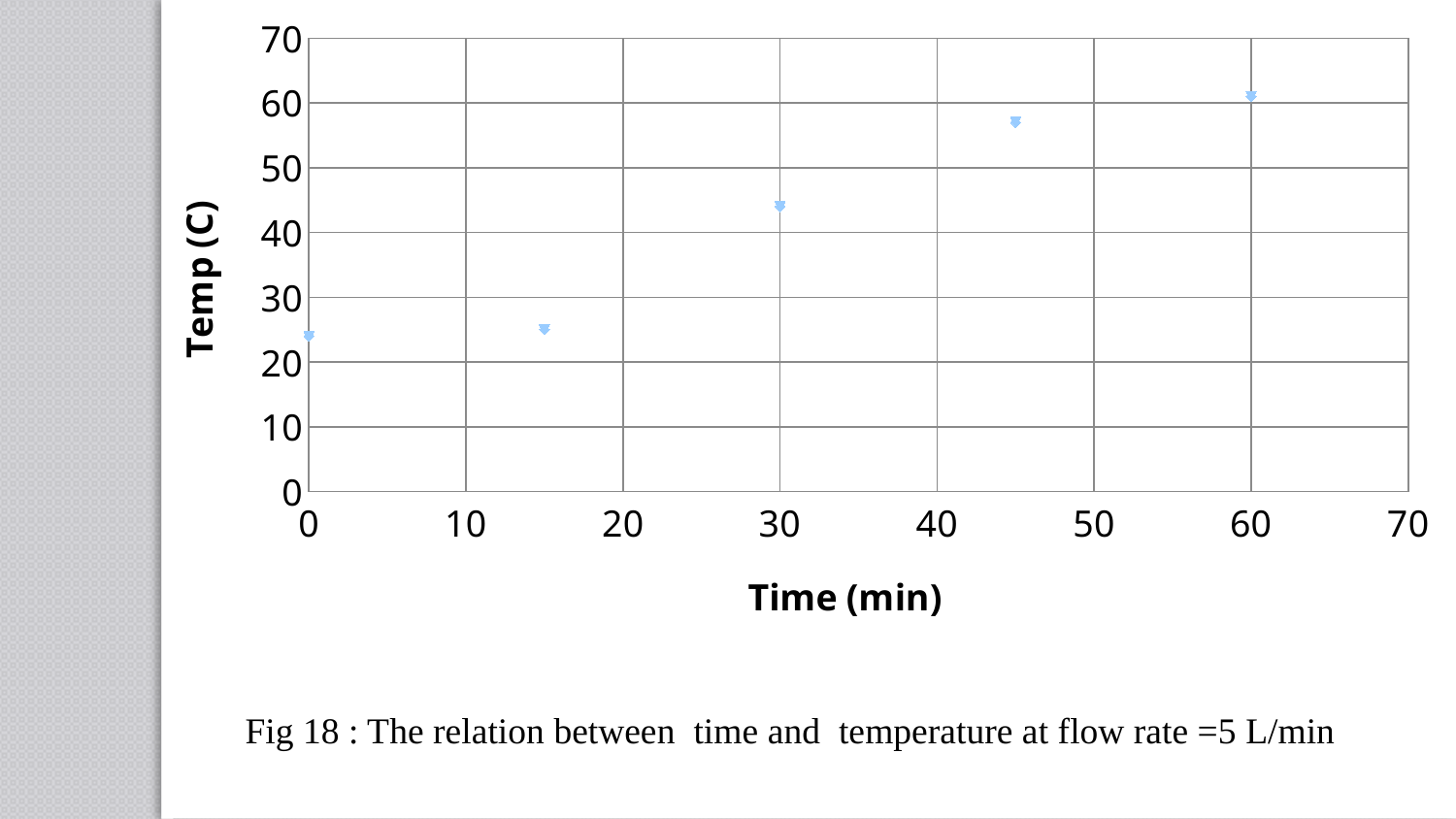
Do the temperature values rise or fall as time increases along the x axis? rise At which time (in minutes) is the temperature highest? 60 What flow rate does the figure caption say the chart corresponds to? 5 L/min How many data points are plotted on the chart? 5 What kind of chart is shown on the slide? scatter chart Is the temperature at 15 min greater or less than 30? less What is the label of the y axis? Temp (C) Which has the higher temperature, 30 min or 45 min? 45 min Is the temperature at 45 min greater or less than 60? less Is the temperature at 30 min greater or less than 40? greater